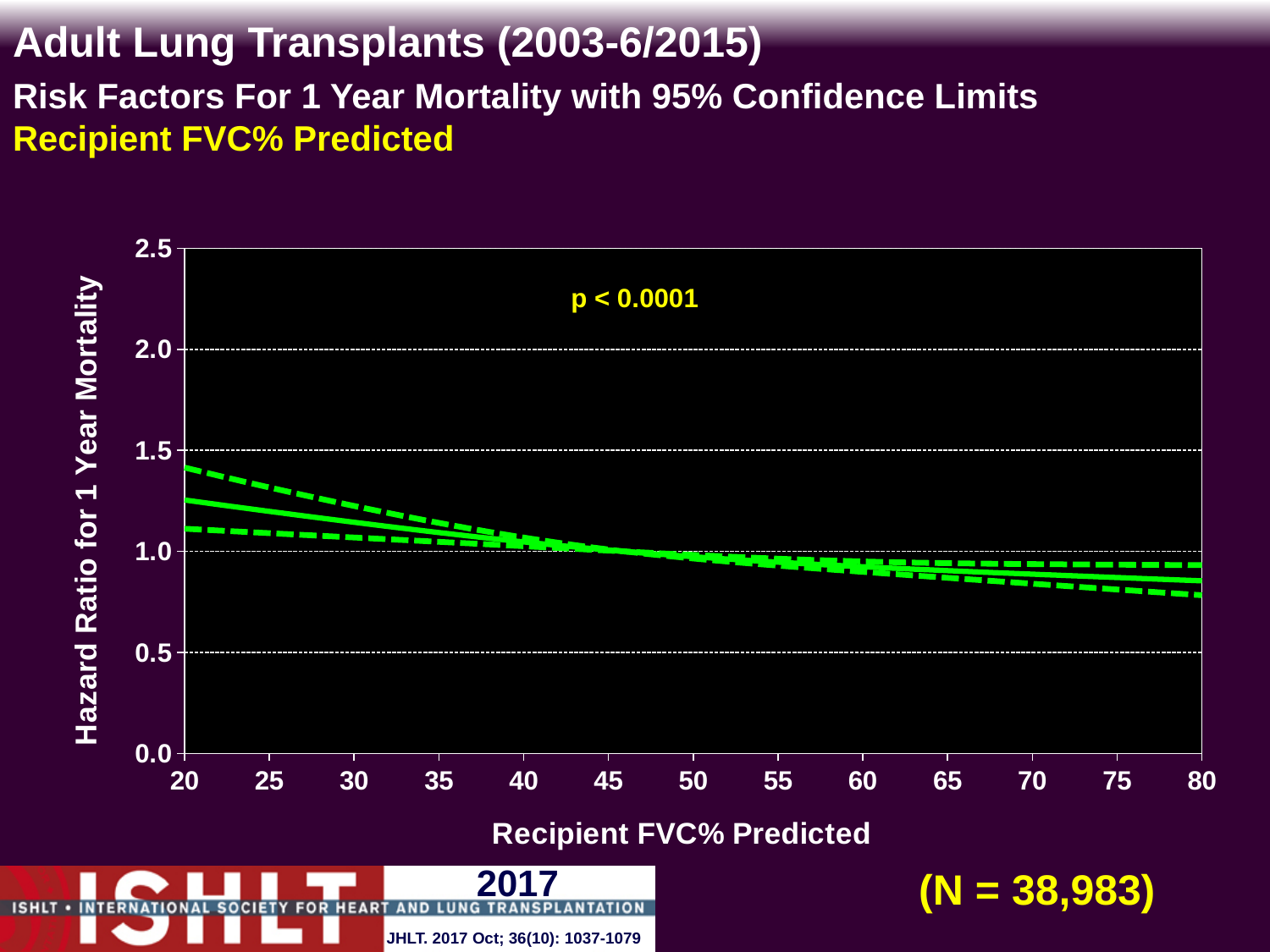
What p-value is printed on the chart? p < 0.0001 What is the sample size (N) shown on the slide? 38,983 What kind of chart is shown on the slide? line chart Is the hazard ratio for 1 year mortality at Recipient FVC% Predicted of 20 greater or less than 1.5? less What is the label of the y axis? Hazard Ratio for 1 Year Mortality Which has the higher hazard ratio for 1 year mortality: Recipient FVC% Predicted of 20 or 80? 20 What is the label of the x axis? Recipient FVC% Predicted What is the highest value shown on the y axis? 2.5 Is the hazard ratio for 1 year mortality at Recipient FVC% Predicted of 20 greater or less than 1.0? greater Does the hazard ratio rise or fall as Recipient FVC% Predicted increases from 20 to 80? fall Is the hazard ratio for 1 year mortality at Recipient FVC% Predicted of 80 greater or less than 1.0? less